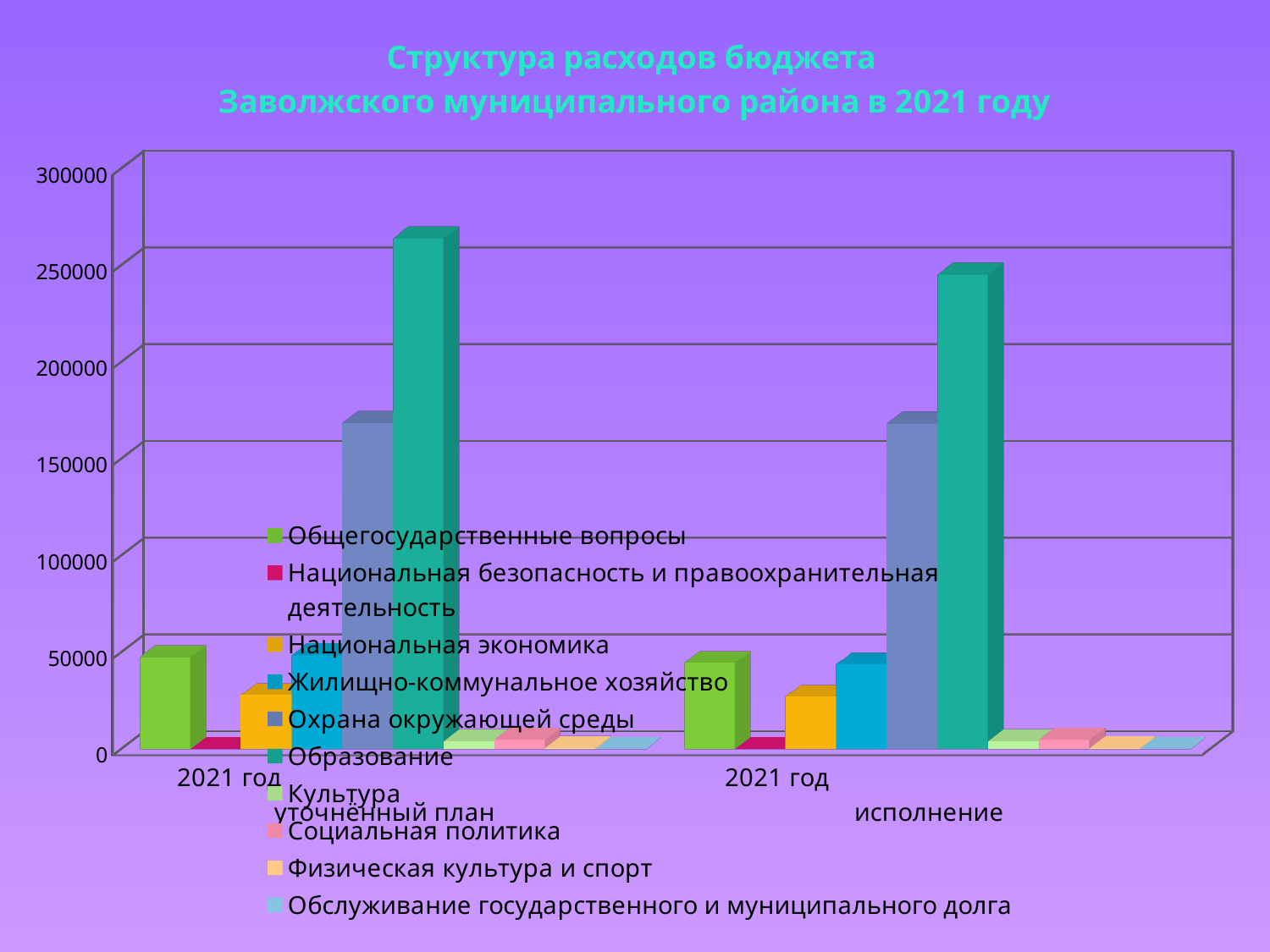
Which series has the highest value in the '2021 год уточнённый план' category? Образование What is the title of the chart? Структура расходов бюджета Заволжского муниципального района в 2021 году How many categories are shown on the x axis? 2 In '2021 год уточнённый план', which is larger: Общегосударственные вопросы or Национальная экономика? Общегосударственные вопросы Does the value for Образование rise or fall from '2021 год уточнённый план' to '2021 год исполнение'? fall What kind of chart is shown on the slide? bar chart Is the value for Образование in '2021 год уточнённый план' greater or less than 250000? greater Is the value for Охрана окружающей среды in '2021 год уточнённый план' greater or less than 150000? greater How many series does the legend list? 10 Is the value for Образование in '2021 год исполнение' greater or less than 200000? greater Which series has the highest value in the '2021 год исполнение' category? Образование